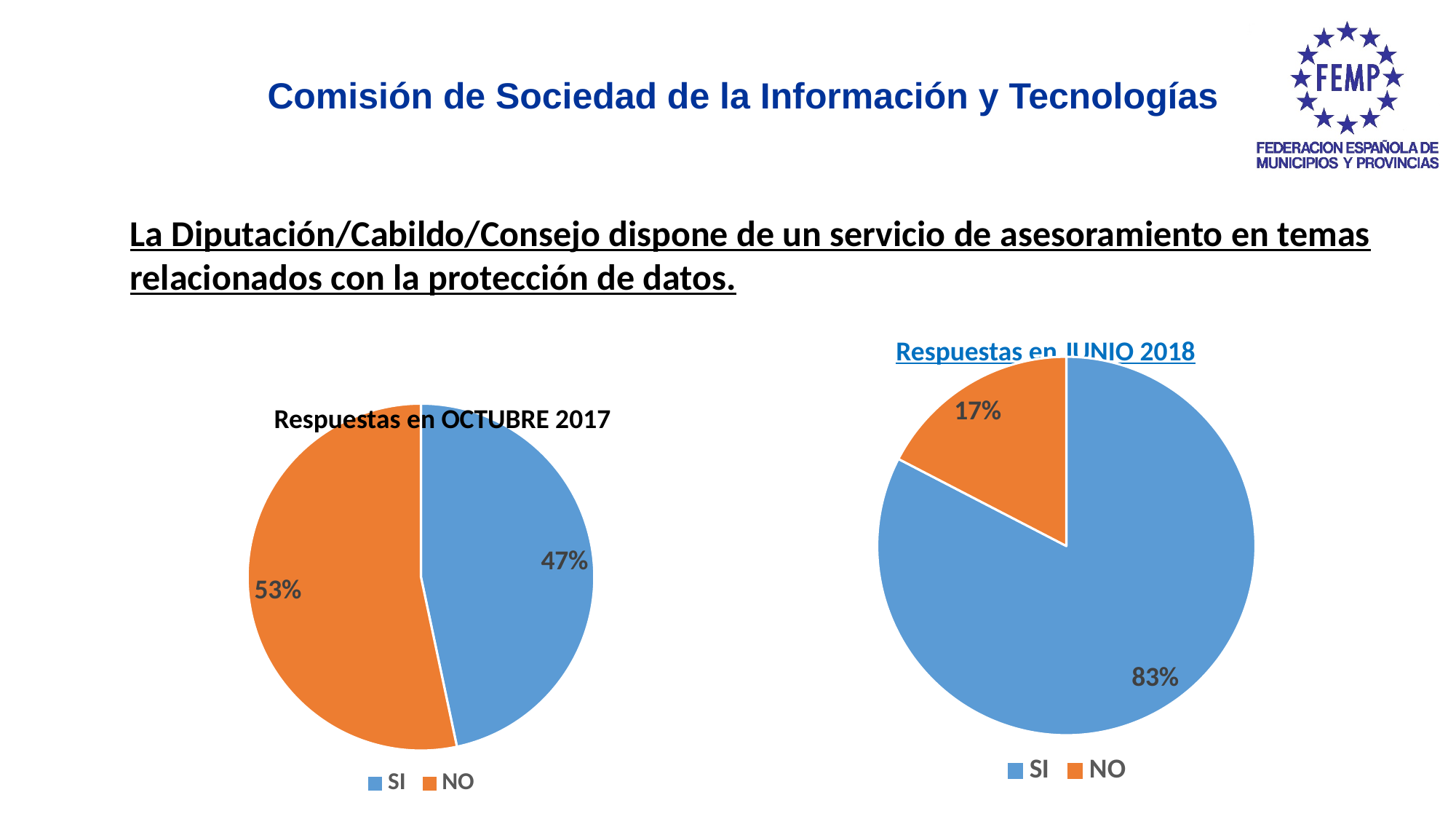
In the 'Respuestas en JUNIO 2018' chart, which is larger, SI or NO? SI In the 'Respuestas en OCTUBRE 2017' chart, which colour represents NO? Orange In the 'Respuestas en OCTUBRE 2017' chart, what share of responses is NO? 53% In the 'Respuestas en OCTUBRE 2017' chart, what share of responses is SI? 47% In the 'Respuestas en OCTUBRE 2017' chart, which slice is the largest? NO How many slices does the 'Respuestas en JUNIO 2018' chart have? 2 In the 'Respuestas en JUNIO 2018' chart, what share of responses is NO? 17% In the 'Respuestas en JUNIO 2018' chart, what is the difference between the SI and NO shares? 66% In the 'Respuestas en OCTUBRE 2017' chart, what is the difference between the NO and SI shares? 6% What kind of chart is 'Respuestas en OCTUBRE 2017'? Pie chart In the 'Respuestas en JUNIO 2018' chart, which slice is the smallest? NO